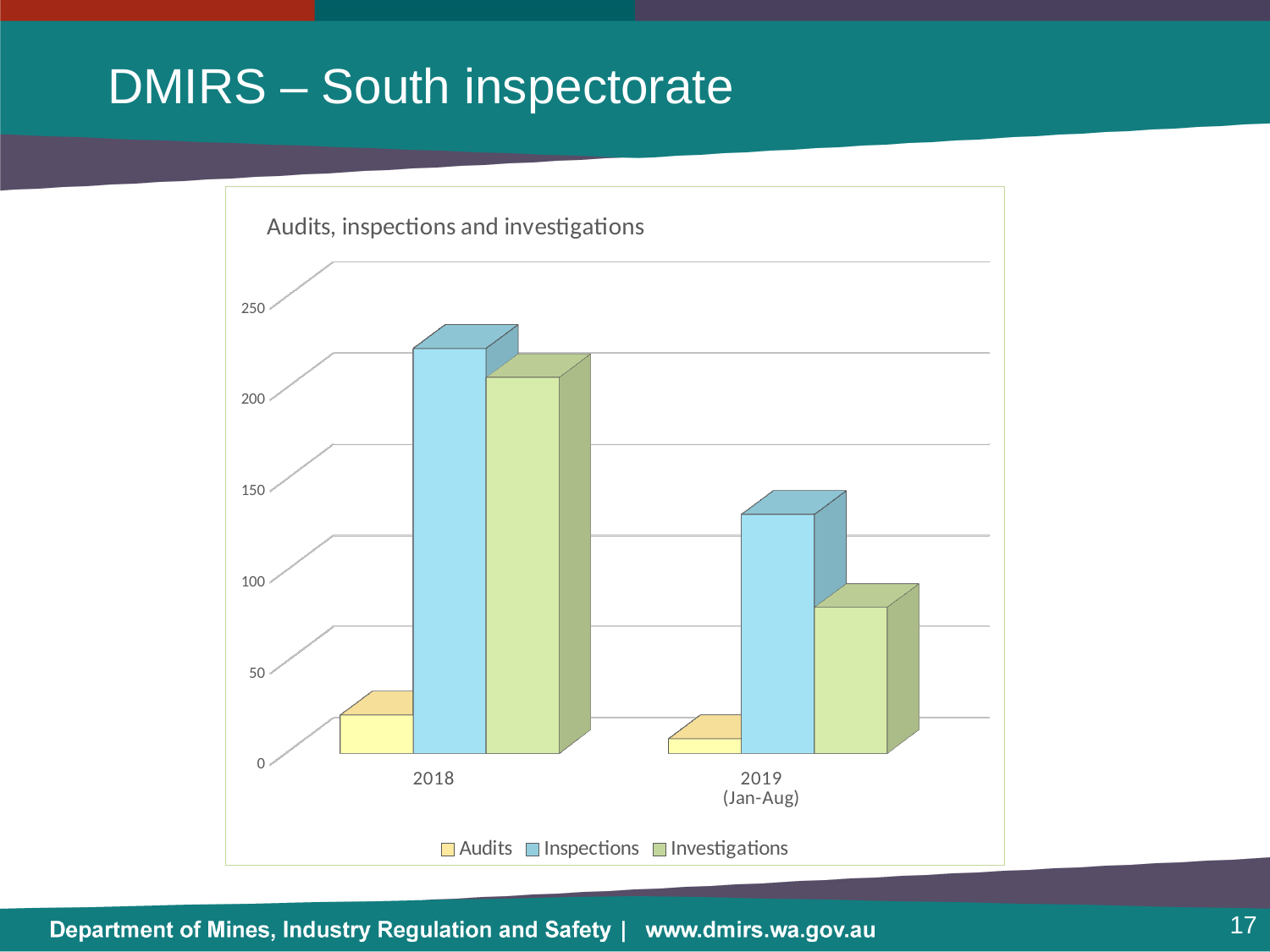
What is the title of the chart? Audits, inspections and investigations Is the value for Audits in 2018 greater or less than 50? less How many series does the legend list? 3 Is the value for Investigations in 2019 (Jan-Aug) greater or less than 100? less Do the values for Investigations rise or fall from 2018 to 2019 (Jan-Aug)? Fall What kind of chart is shown on the slide? Bar chart Is the value for Inspections in 2018 greater or less than 200? greater Which is larger, Inspections in 2018 or Inspections in 2019 (Jan-Aug)? Inspections in 2018 Which series has the highest value in 2018? Inspections How many categories are shown on the x axis? 2 Which series has the lowest value in 2019 (Jan-Aug)? Audits